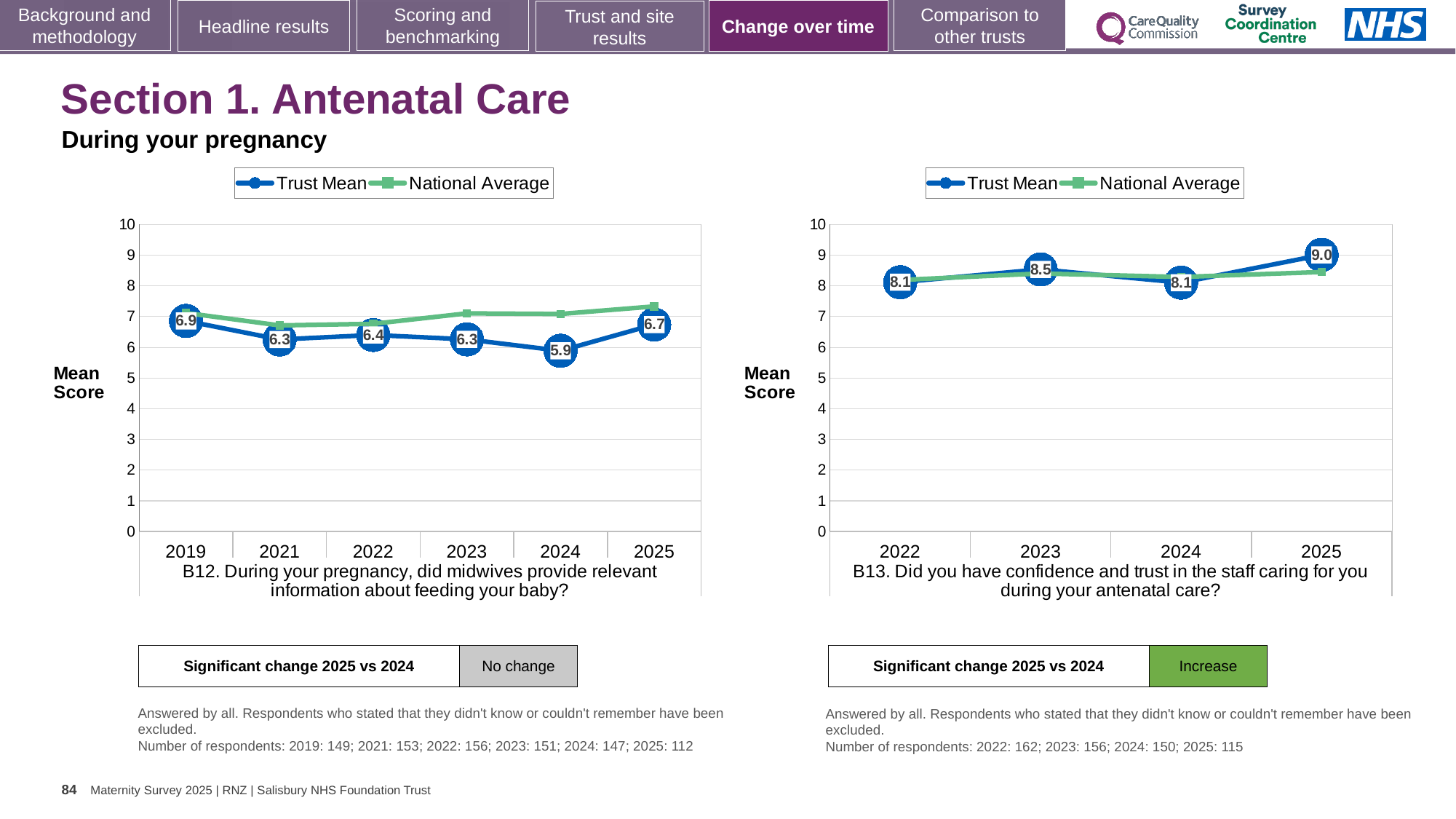
In the B12 chart (left), which year has the highest Trust Mean score? 2019 What type of chart is the B12 chart (left)? Line chart In the B12 chart (left), what is the difference between the Trust Mean scores for 2025 and 2024? 0.8 In the B12 chart (left), how many years are plotted on the x axis? 6 In the B12 chart (left), which year has the lowest Trust Mean score? 2024 In the B13 chart (right), which year has the highest Trust Mean score? 2025 In the B12 chart (left), what is the Trust Mean score for 2019? 6.9 In the B13 chart (right), how many series does the legend list? 2 In the B13 chart (right), what is the difference between the Trust Mean scores for 2023 and 2022? 0.4 In the B12 chart (left), what is the Trust Mean score for 2024? 5.9 In the B13 chart (right), is the Trust Mean score for 2025 greater or less than the National Average for 2025? greater In the B13 chart (right), what is the Trust Mean score for 2025? 9.0